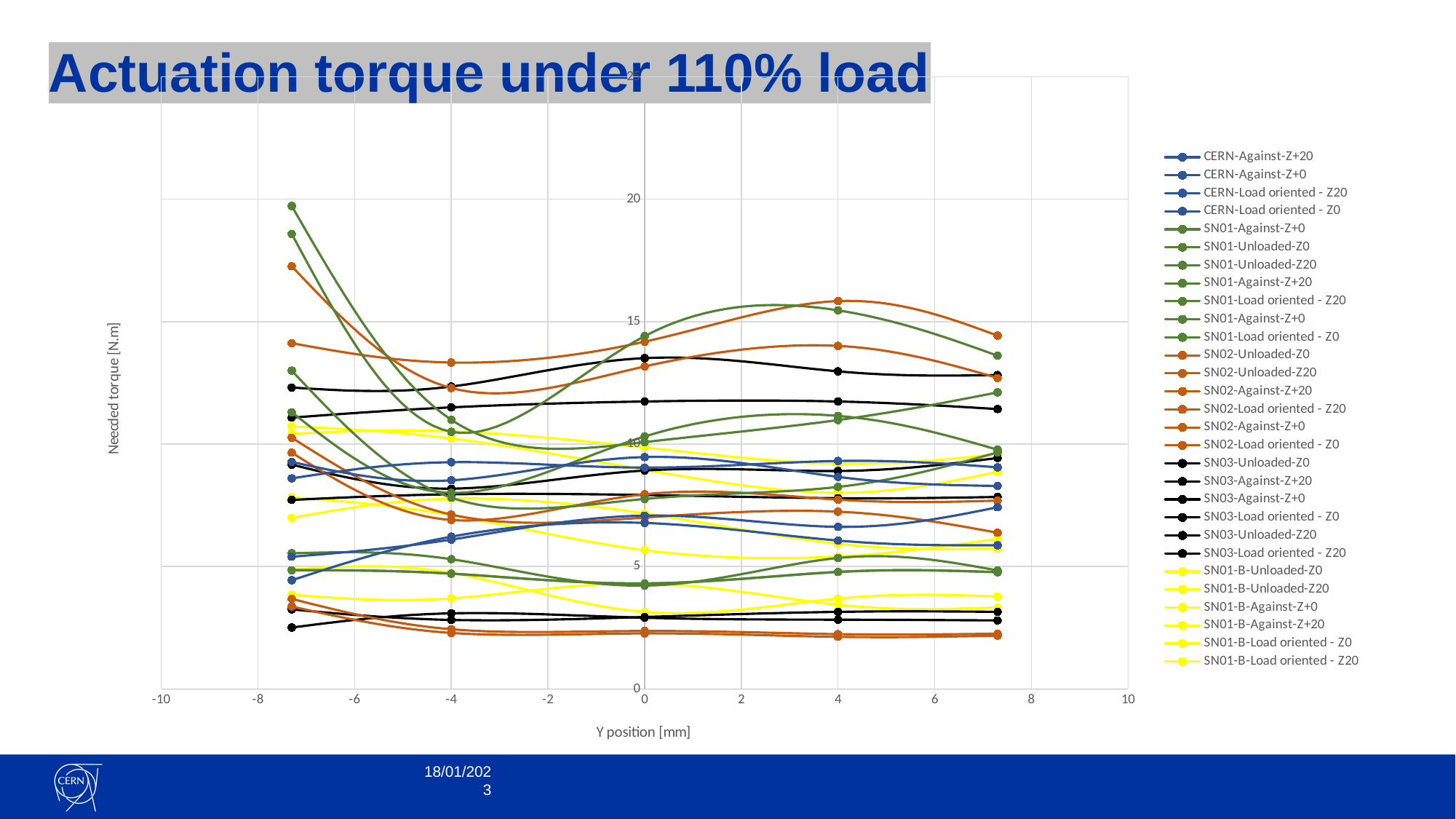
Is the lowest plotted torque value on the chart greater or less than 5? less What is the label of the vertical axis? Needed torque [N.m] Is the highest plotted torque value greater or less than 20? less What is the label of the horizontal axis? Y position [mm] Is the highest plotted torque value on the chart greater or less than 15? greater What kind of chart is shown on the slide? Line chart What is the title of the chart? Actuation torque under 110% load How many series does the chart legend list? 29 How many data points does each series have along the x axis? 5